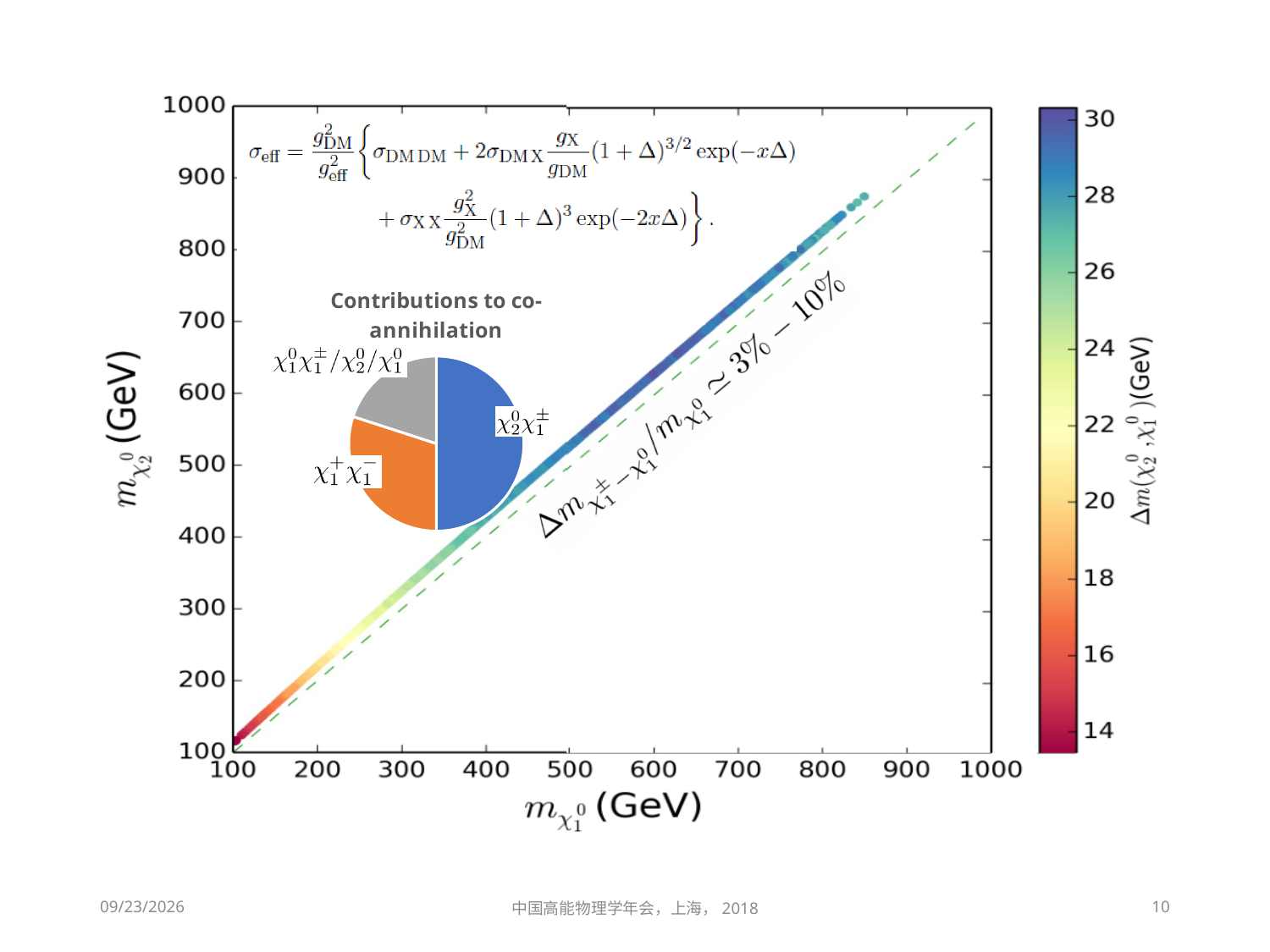
In the 'Contributions to co-annihilation' pie chart, what colour is the χ1⁺χ1⁻ slice? orange In the 'Contributions to co-annihilation' pie chart, which slice is larger: χ1⁺χ1⁻ or χ2⁰χ1±? χ2⁰χ1± What kind of chart is the large plot of m_χ2⁰ versus m_χ1⁰? scatter plot In the large scatter plot, does m_χ2⁰ rise or fall as m_χ1⁰ increases? rise What is the label of the x axis of the large scatter plot? m_χ1⁰ (GeV) In the 'Contributions to co-annihilation' pie chart, which contribution has the smallest slice? χ1⁰χ1±/χ2⁰/χ1⁰ How many slices does the 'Contributions to co-annihilation' pie chart have? 3 In the 'Contributions to co-annihilation' pie chart, which contribution has the largest slice? χ2⁰χ1± In the large scatter plot, is the value of m_χ2⁰ at m_χ1⁰ = 800 GeV greater or less than 700? greater What kind of chart is the 'Contributions to co-annihilation' chart? pie chart What is the maximum value shown on the colour bar of the large scatter plot? 30 In the large scatter plot, is the value of m_χ2⁰ at m_χ1⁰ = 300 GeV greater or less than 500? less